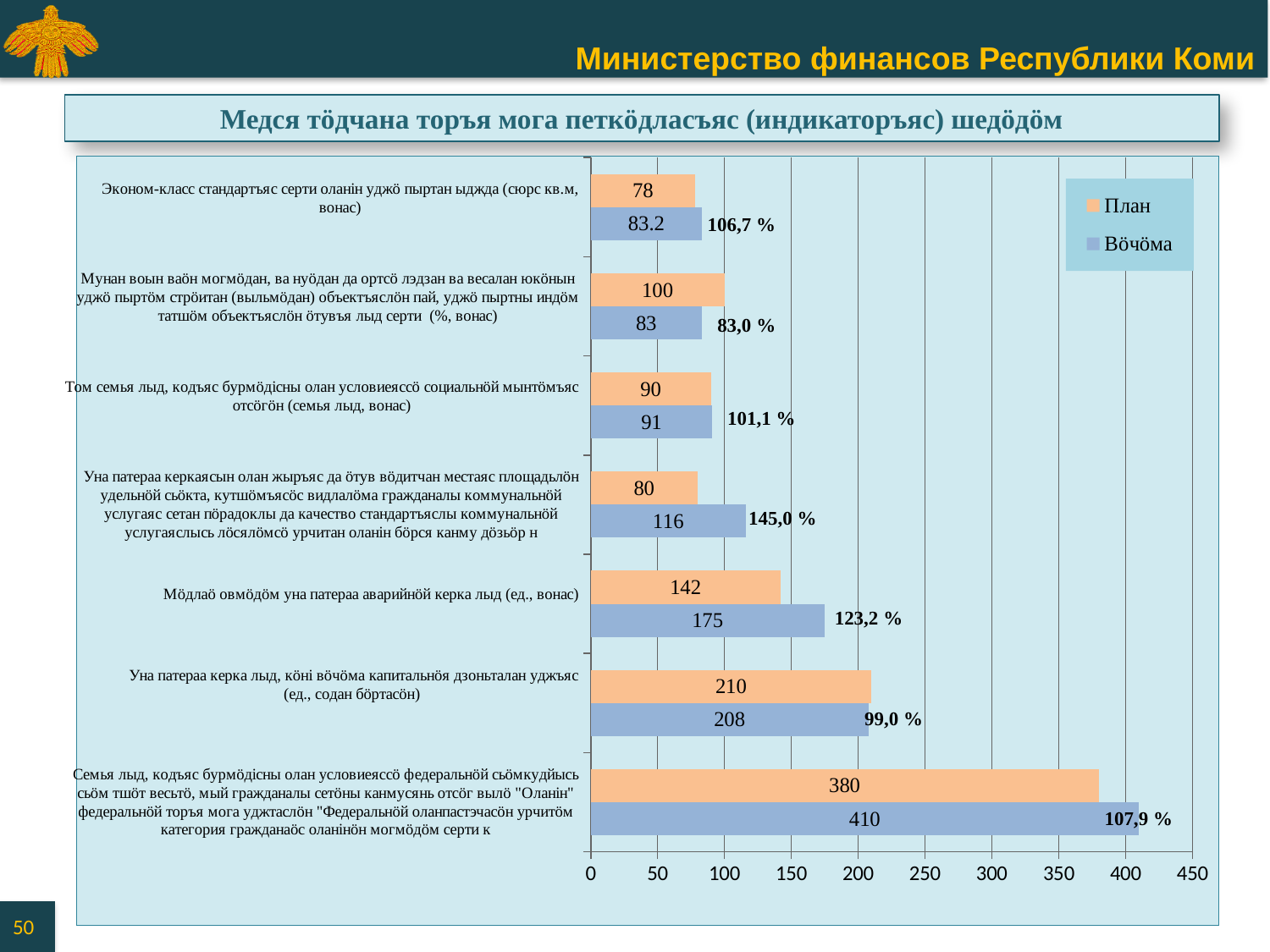
How many series does the legend list? 2 For "Уна патераа керка лыд, кöні вöчöма капитальнöя дзоньталан уджъяс (ед., содан бöртасöн)", which is larger, План or Вöчöма? План Which series is shown in blue in the legend? Вöчöма What is the difference between the Вöчöма and План values for "Мöдлаö овмöдöм уна патераа аварийнöй керка лыд (ед., вонас)"? 33 What is the Вöчöма value for "Эконом-класс стандартъяс серти оланін уджö пыртан ыджда (сюрс кв.м, вонас)"? 83.2 Which category has the highest Вöчöма value? Семья лыд, кодъяс бурмöдісны олан условиеяссö федеральнöй сьöмкудйысь сьöм тшöт весьтö... How many categories are shown on the chart? 7 Is the Вöчöма value for "Семья лыд, кодъяс бурмöдісны олан условиеяссö федеральнöй сьöмкудйысь..." greater or less than 400? greater What is the План value for "Мöдлаö овмöдöм уна патераа аварийнöй керка лыд (ед., вонас)"? 142 What percentage is printed next to the Вöчöма bar for "Уна патераа керкаясын олан жыръяс да öтув вöдитчан местаяс площадьлöн удельнöй сьöкта..."? 145,0 % Which category has the lowest План value? Эконом-класс стандартъяс серти оланін уджö пыртан ыджда (сюрс кв.м, вонас) What kind of chart is shown on the slide? Bar chart